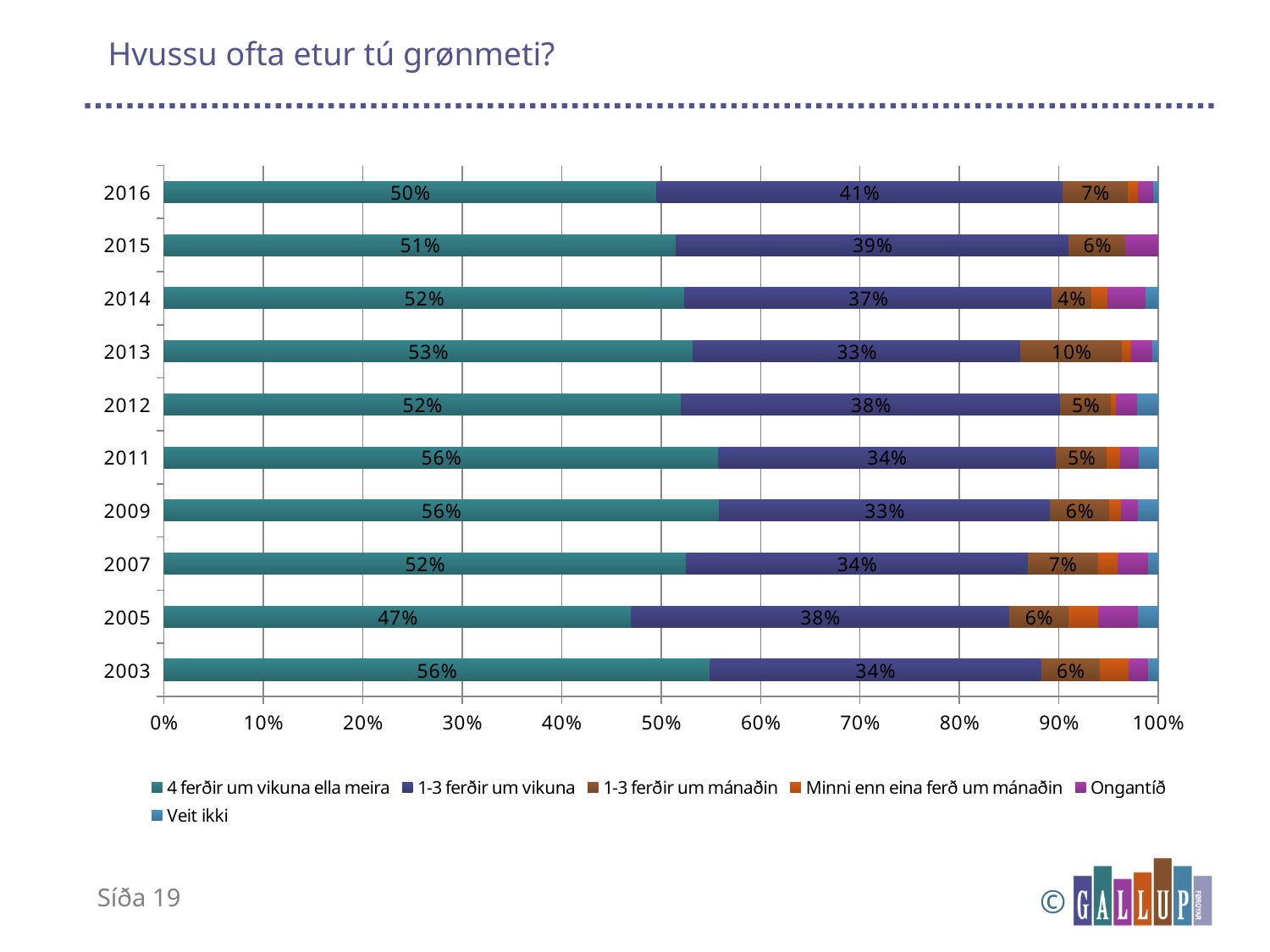
How many years are shown on the chart? 10 What kind of chart is shown on the slide? Stacked bar chart Is the value for "1-3 ferðir um vikuna" larger in 2015 or in 2016? 2016 Which year has the highest value for "1-3 ferðir um vikuna"? 2016 What is the value for "1-3 ferðir um vikuna" in 2005? 38% How many series does the legend list? 6 What is the value for "4 ferðir um vikuna ella meira" in 2016? 50% In 2013, what is the difference between "4 ferðir um vikuna ella meira" and "1-3 ferðir um vikuna"? 20 percentage points Which year has the highest value for "1-3 ferðir um mánaðin"? 2013 What is the value for "1-3 ferðir um mánaðin" in 2013? 10% Which year has the lowest value for "4 ferðir um vikuna ella meira"? 2005 What is the title of the chart? Hvussu ofta etur tú grønmeti?